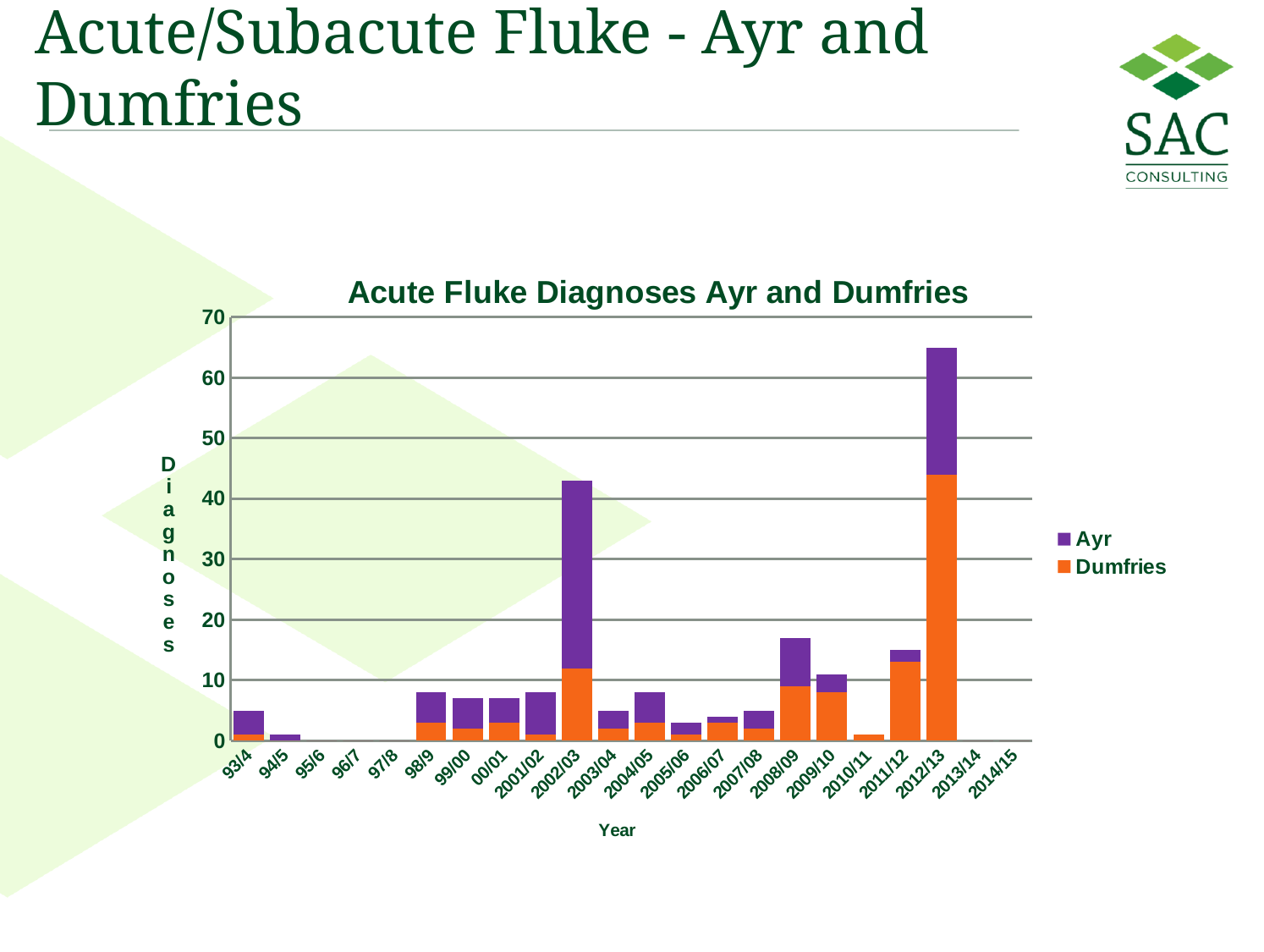
Is the total for 2002/03 greater or less than 40? greater Which has the larger total, 2002/03 or 2008/09? 2002/03 What kind of chart is shown on the slide? Stacked bar chart Is the total for 2012/13 greater or less than 60? greater Which year has the highest total number of diagnoses? 2012/13 How many year categories are shown on the x axis? 22 Is the total for 2003/04 greater or less than 10? less What is the title of the chart? Acute Fluke Diagnoses Ayr and Dumfries How many series does the legend list? 2 Which series is shown in orange? Dumfries